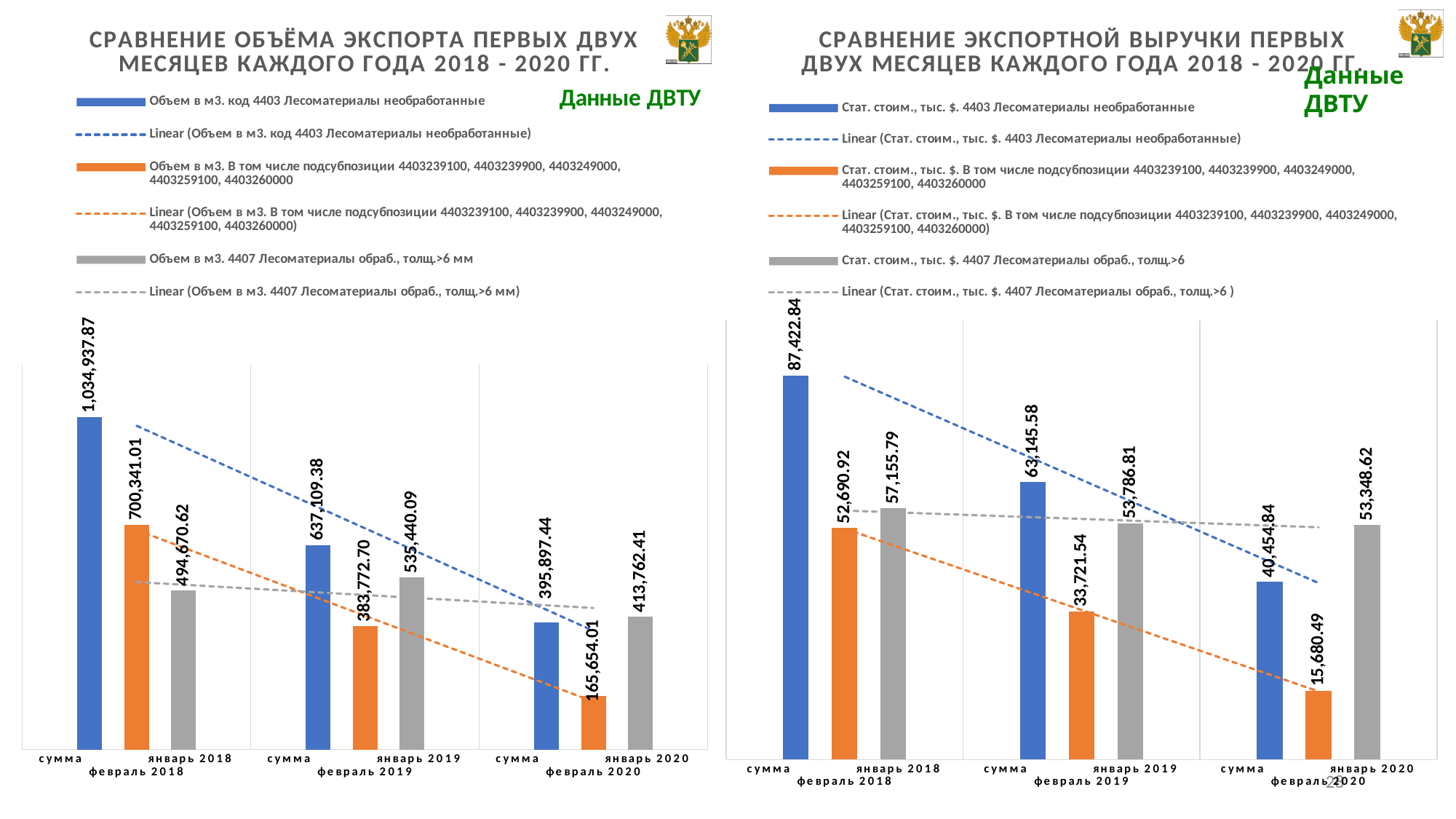
On the right chart (export revenue), what is the value of the blue series (4403 Лесоматериалы необработанные) for 2018? 87,422.84 On the left chart (export volume), what is the value of the orange series (подсубпозиции) for 2020? 165,654.01 On the left chart (export volume), what is the value of the grey series (4407 Лесоматериалы обраб.) for 2019? 535,440.09 On the left chart (export volume), does the blue series (код 4403) rise or fall from 2018 to 2020? fall What kind of chart is the left chart (export volume)? bar chart On the right chart (export revenue), in which year is the orange series (подсубпозиции) lowest? 2020 On the left chart (export volume), what is the value of the blue series (код 4403 Лесоматериалы необработанные) for 2018? 1,034,937.87 On the left chart (export volume), what is the difference between the blue series values for 2018 and 2019? 397,828.49 On the right chart (export revenue), what is the value of the grey series (4407) for 2020? 53,348.62 On the right chart (export revenue), which is larger for 2020: the blue series (4403) or the grey series (4407)? grey series (4407), 53,348.62 On the right chart (export revenue), what is the value of the orange series (подсубпозиции) for 2019? 33,721.54 On the left chart (export volume), in which year is the blue series (код 4403) highest? 2018